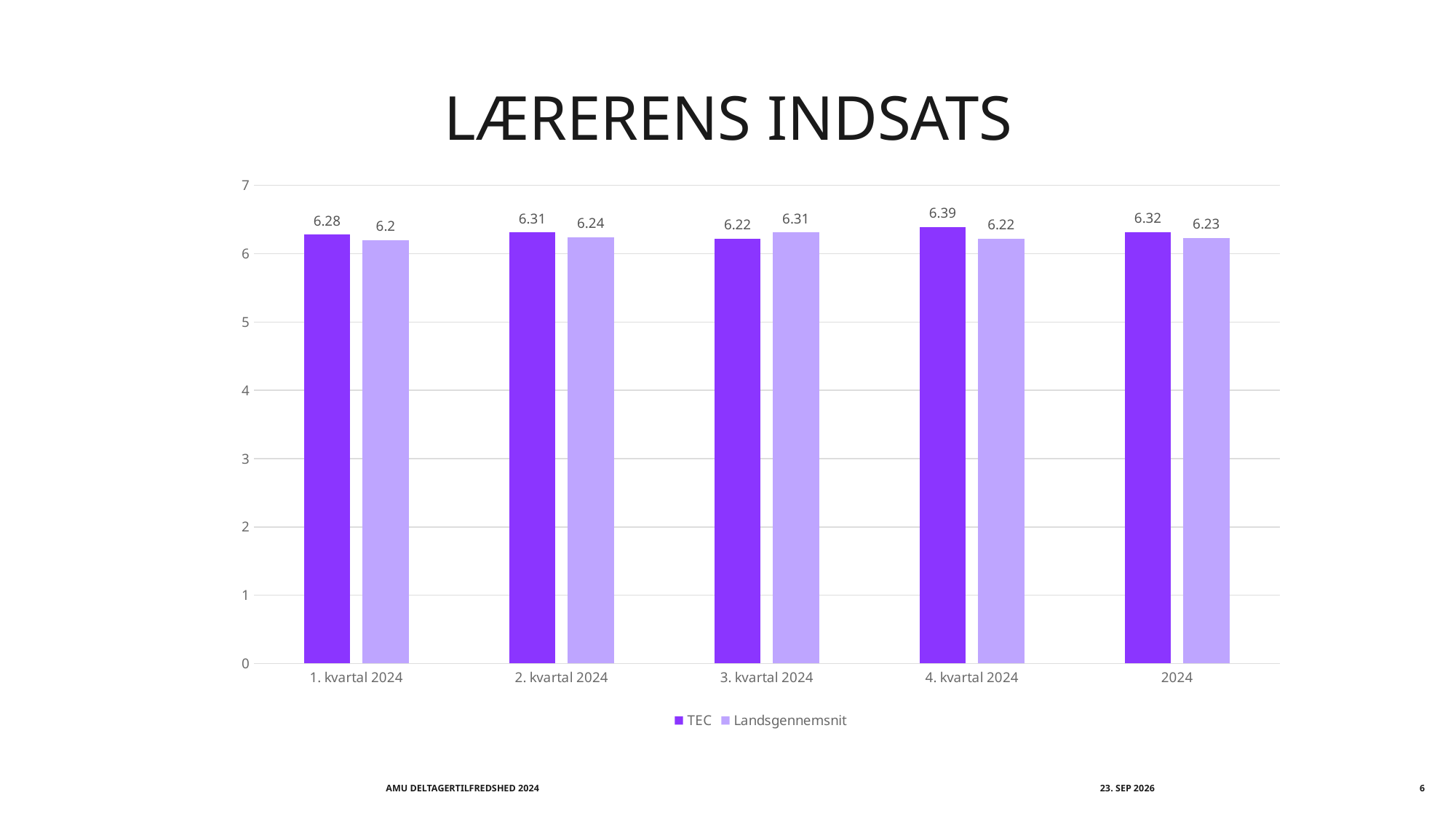
How many categories are shown on the x axis? 5 Which category has the highest TEC value? 4. kvartal 2024 What is the Landsgennemsnit value for 3. kvartal 2024? 6.31 Which category has the lowest TEC value? 3. kvartal 2024 What kind of chart is shown on the slide? Bar chart What is the title of the slide? LÆRERENS INDSATS What is the Landsgennemsnit value for 1. kvartal 2024? 6.2 What is the difference between the TEC and Landsgennemsnit values for 4. kvartal 2024? 0.17 What is the TEC value for 1. kvartal 2024? 6.28 How many series does the legend list? 2 Which is larger for 3. kvartal 2024, TEC or Landsgennemsnit? Landsgennemsnit What is the TEC value for 2024? 6.32